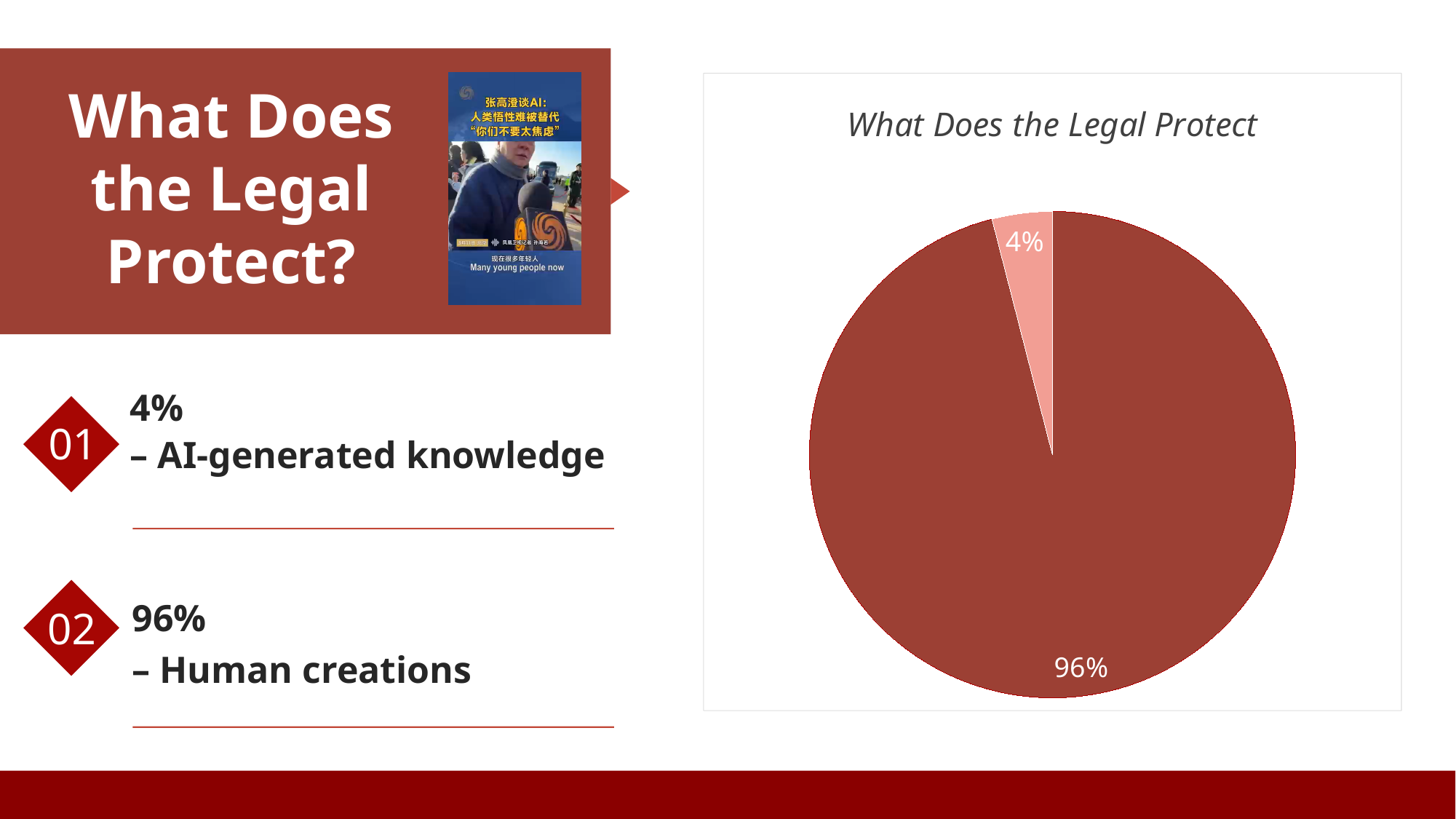
What colour is the slice labelled 4%? light pink Which category has the smallest share of the pie chart? AI-generated knowledge What percentage is shown on the larger slice of the pie chart? 96% Which category has the largest share of the pie chart? Human creations What is the difference in percentage points between the two slices of the pie chart? 92 According to the slide, what share of the pie corresponds to Human creations? 96% According to the slide, what share of the pie corresponds to AI-generated knowledge? 4% What percentage is shown on the smaller, light pink slice of the pie chart? 4% What kind of chart is shown on the slide? pie chart What is the title of the chart? What Does the Legal Protect How many slices does the pie chart have? 2 Which slice is larger: the dark red slice or the light pink slice? the dark red slice